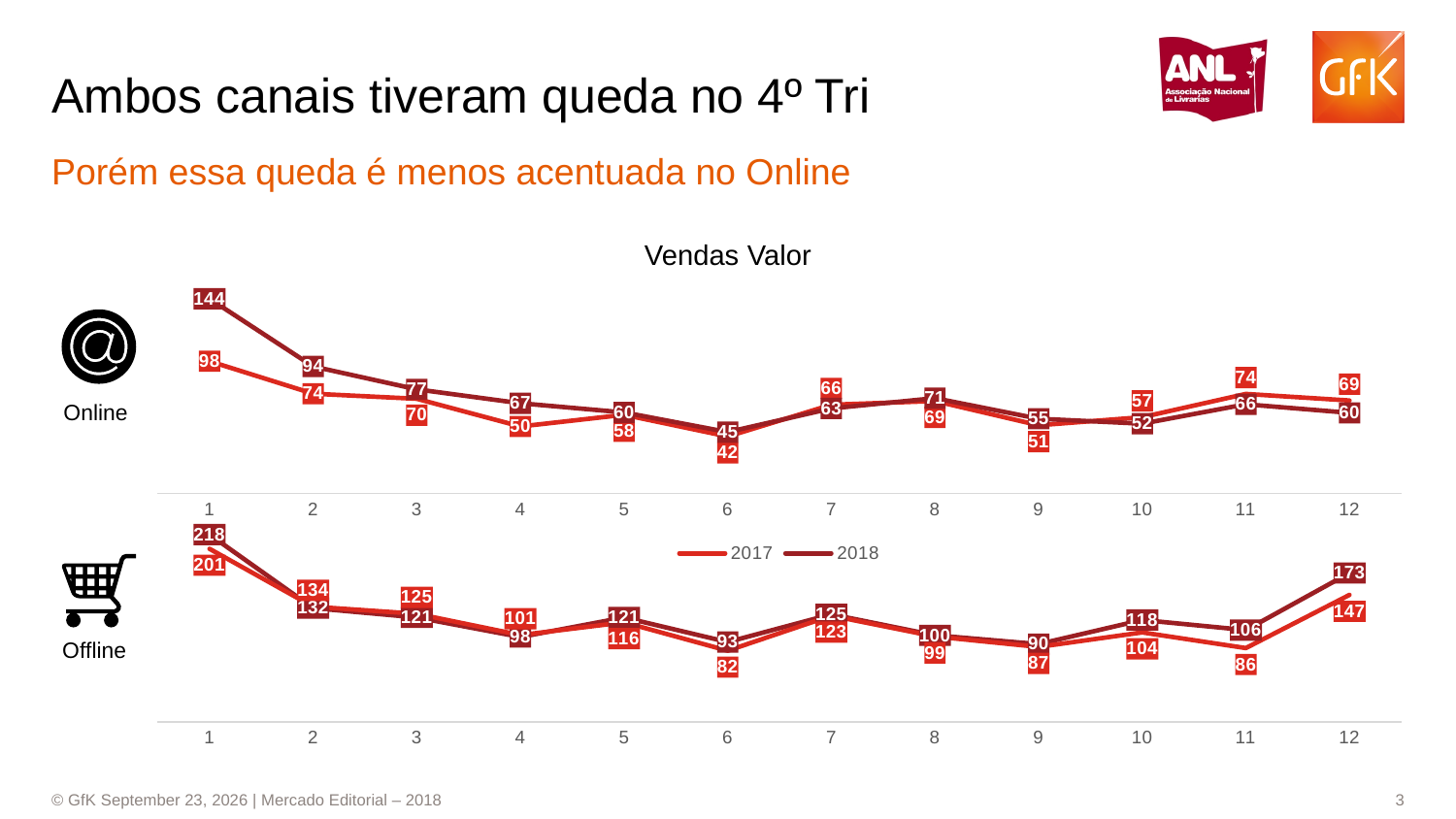
What is the title shown above the charts? Vendas Valor How many points along the x axis does the Online chart have? 12 On the Offline chart, which month has the larger top value, month 1 or month 12? month 1 What kind of chart is used for the Online and Offline sales on this slide? line chart On the Offline chart, what is the highest value shown? 218 On the Online chart, what is the lowest value shown? 42 On the Online chart, what is the highest value shown? 144 How many series does the legend list? 2 On the Online chart, what is the difference between the two values at month 1 (144 and 98)? 46 On the Online chart, do the values generally rise or fall from month 1 to month 6? fall On the Offline chart, what is the lowest value shown? 82 On the Offline chart, what is the difference between the two values at month 12 (173 and 147)? 26